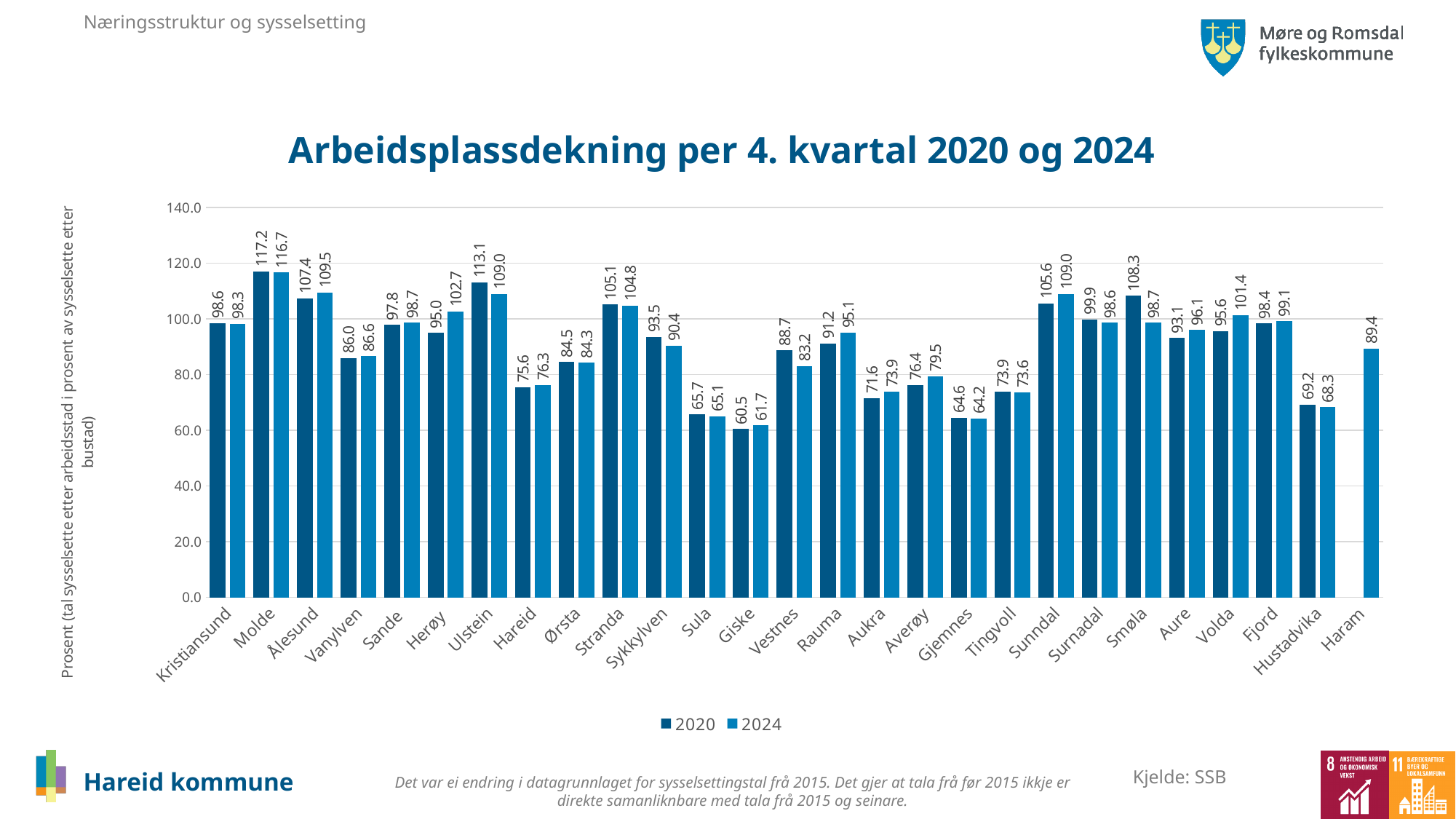
How many municipalities (categories) are shown on the x axis? 27 How many series does the legend list? 2 What is the difference between the 2024 and 2020 values for Herøy? 7.7 What is the title of the chart? Arbeidsplassdekning per 4. kvartal 2020 og 2024 Which is larger for Volda: the 2020 value or the 2024 value? 2024 What is the difference between the 2020 and 2024 values for Smøla? 9.6 What is the 2020 value for Ulstein? 113.1 Which municipality has the highest 2020 value? Molde What is the 2024 value for Hareid? 76.3 What is the 2024 value for Haram? 89.4 Which municipality has the lowest 2024 value? Giske What type of chart is shown on the slide? bar chart